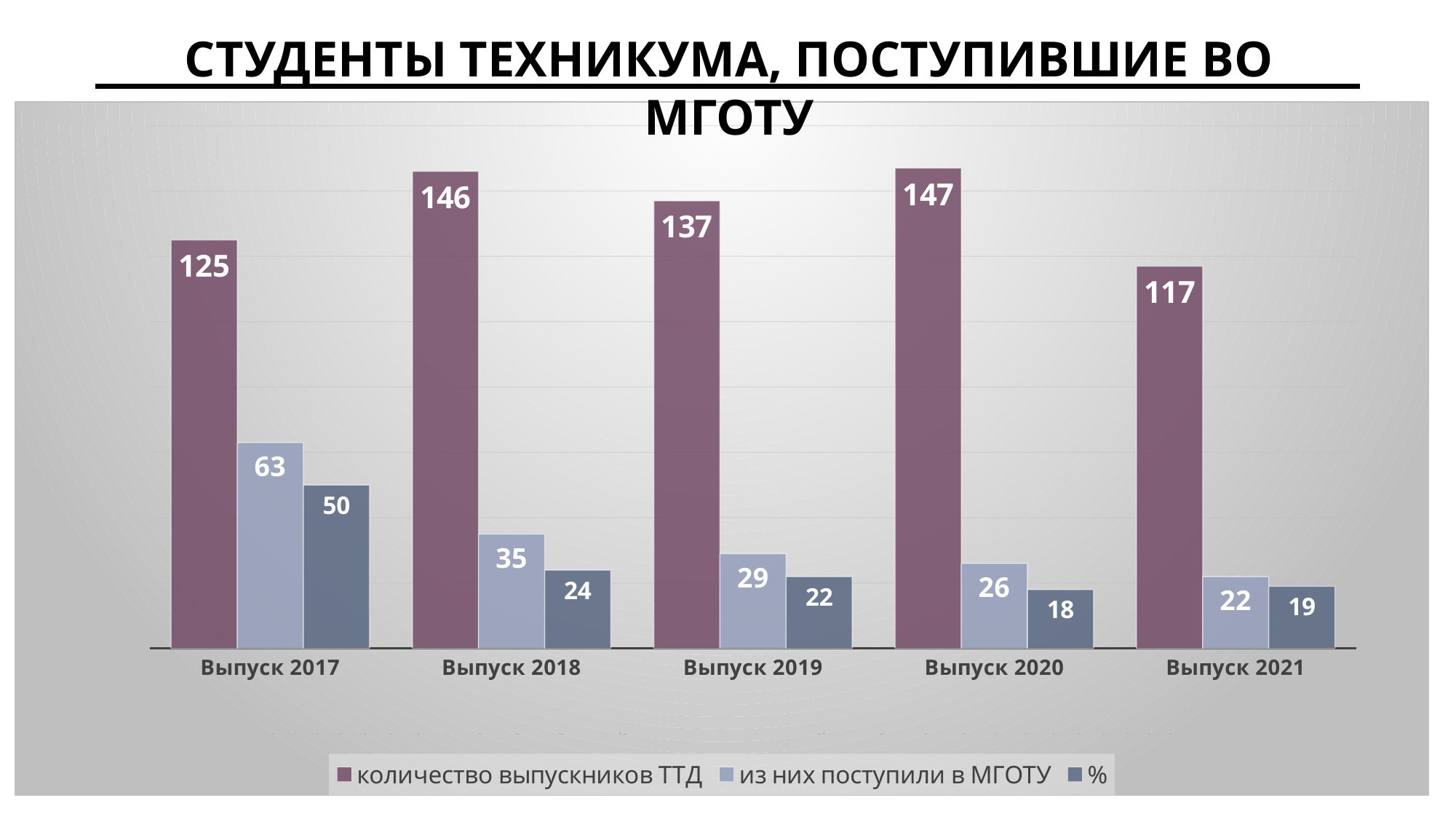
What is the difference between "количество выпускников ТТД" for Выпуск 2020 and Выпуск 2021? 30 Which is larger: "из них поступили в МГОТУ" for Выпуск 2018 or for Выпуск 2019? Выпуск 2018 Does the "%" series rise or fall from Выпуск 2017 to Выпуск 2020? Fall What kind of chart is shown on the slide? Bar chart What is the "%" value for Выпуск 2021? 19 Which year has the highest value for "количество выпускников ТТД"? Выпуск 2020 How many series does the legend list? 3 How many years (categories) are shown on the x axis? 5 Which year has the lowest value for "из них поступили в МГОТУ"? Выпуск 2021 What is the title of the chart? СТУДЕНТЫ ТЕХНИКУМА, ПОСТУПИВШИЕ ВО МГОТУ What is the value of "из них поступили в МГОТУ" for Выпуск 2017? 63 What is the value of "количество выпускников ТТД" for Выпуск 2018? 146